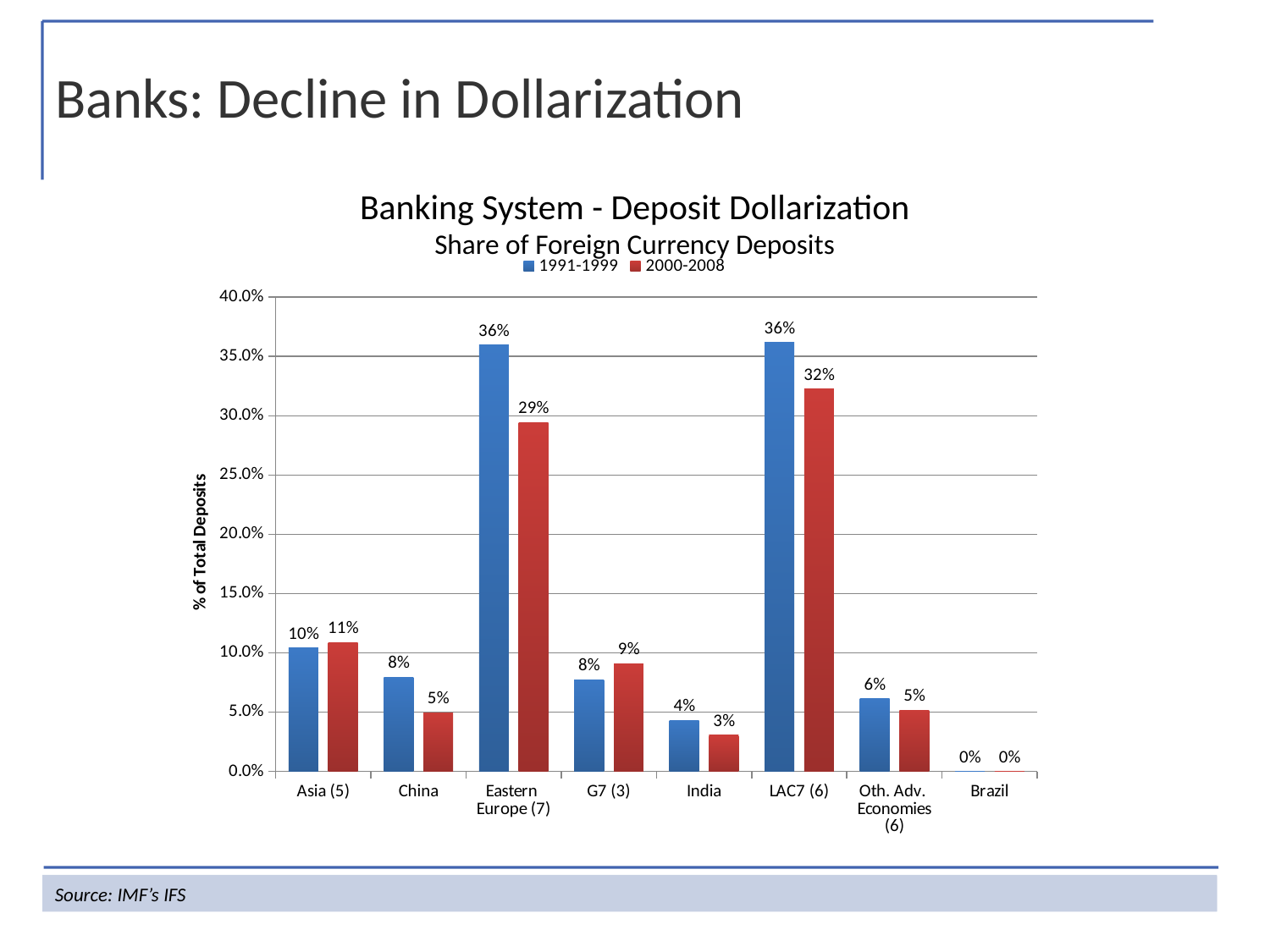
What is the value for India in the 2000-2008 series? 3% Which category has the highest value in the 2000-2008 series? LAC7 (6) For China, which series has the larger value, 1991-1999 or 2000-2008? 1991-1999 How many series does the legend list? 2 What is the value for LAC7 (6) in the 2000-2008 series? 32% Which category has the lowest value in the 1991-1999 series? Brazil What is the difference between the 1991-1999 and 2000-2008 values for Eastern Europe (7)? 7 percentage points What is the value for Eastern Europe (7) in the 1991-1999 series? 36% Is the 2000-2008 value for Eastern Europe (7) greater or less than 25.0%? greater How many categories are shown on the x axis? 8 What is the label of the y axis? % of Total Deposits What kind of chart is shown on the slide? Bar chart